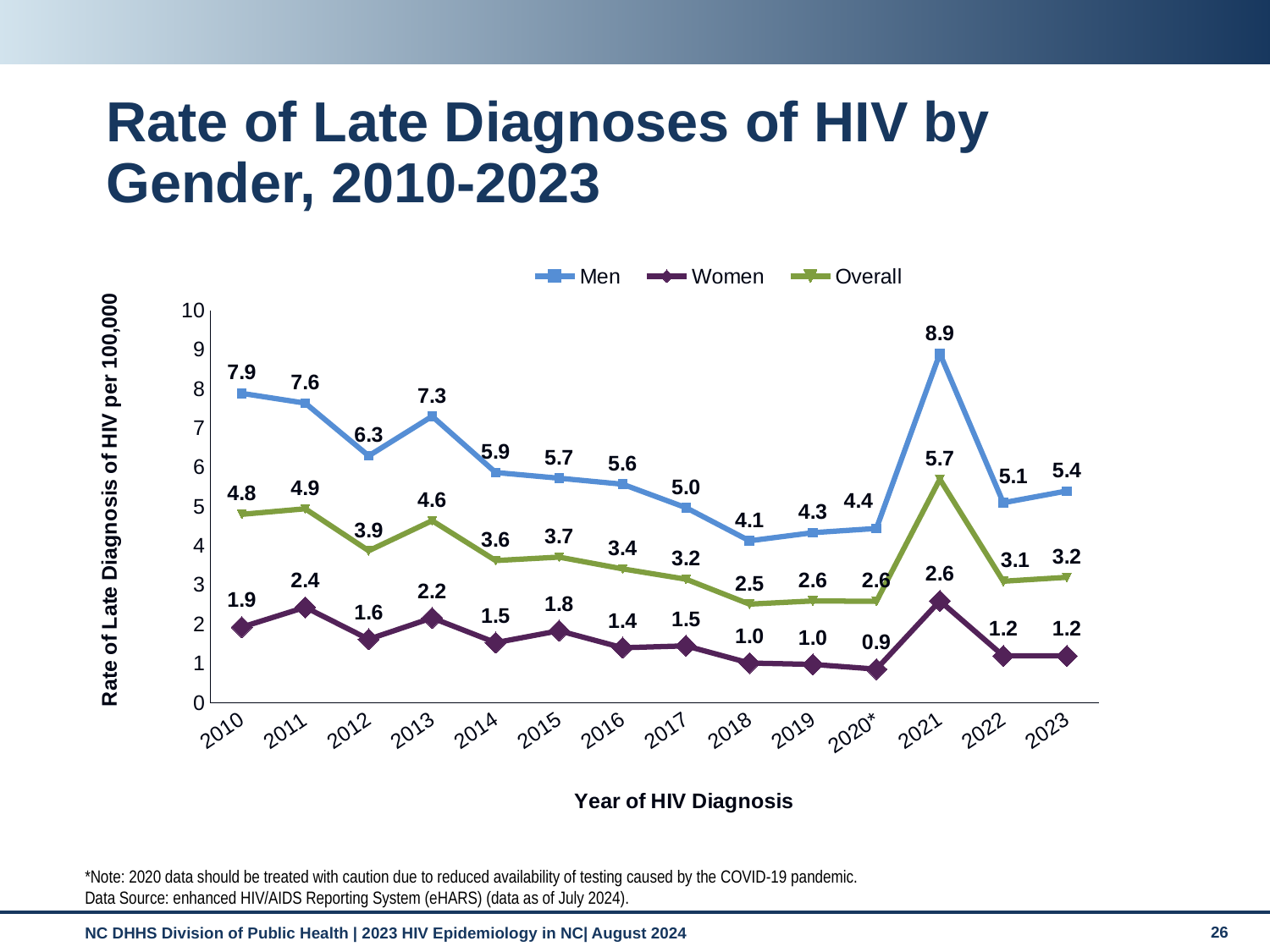
What is the label of the y axis? Rate of Late Diagnosis of HIV per 100,000 Did the rate for Men rise or fall from 2010 to 2018? fall What is the difference between the Men rate and the Women rate in 2010? 6.0 What kind of chart is shown on the slide? line chart In which year is the rate for Women lowest? 2020* What is the rate of late diagnoses of HIV for Women in 2020*? 0.9 What is the rate of late diagnoses of HIV for Men in 2021? 8.9 How many series does the legend list? 3 What is the Overall rate of late diagnoses of HIV in 2023? 3.2 Which is larger, the Overall rate in 2011 or the Overall rate in 2013? 2011 In which year is the rate for Men highest? 2021 How many years are shown on the x axis? 14